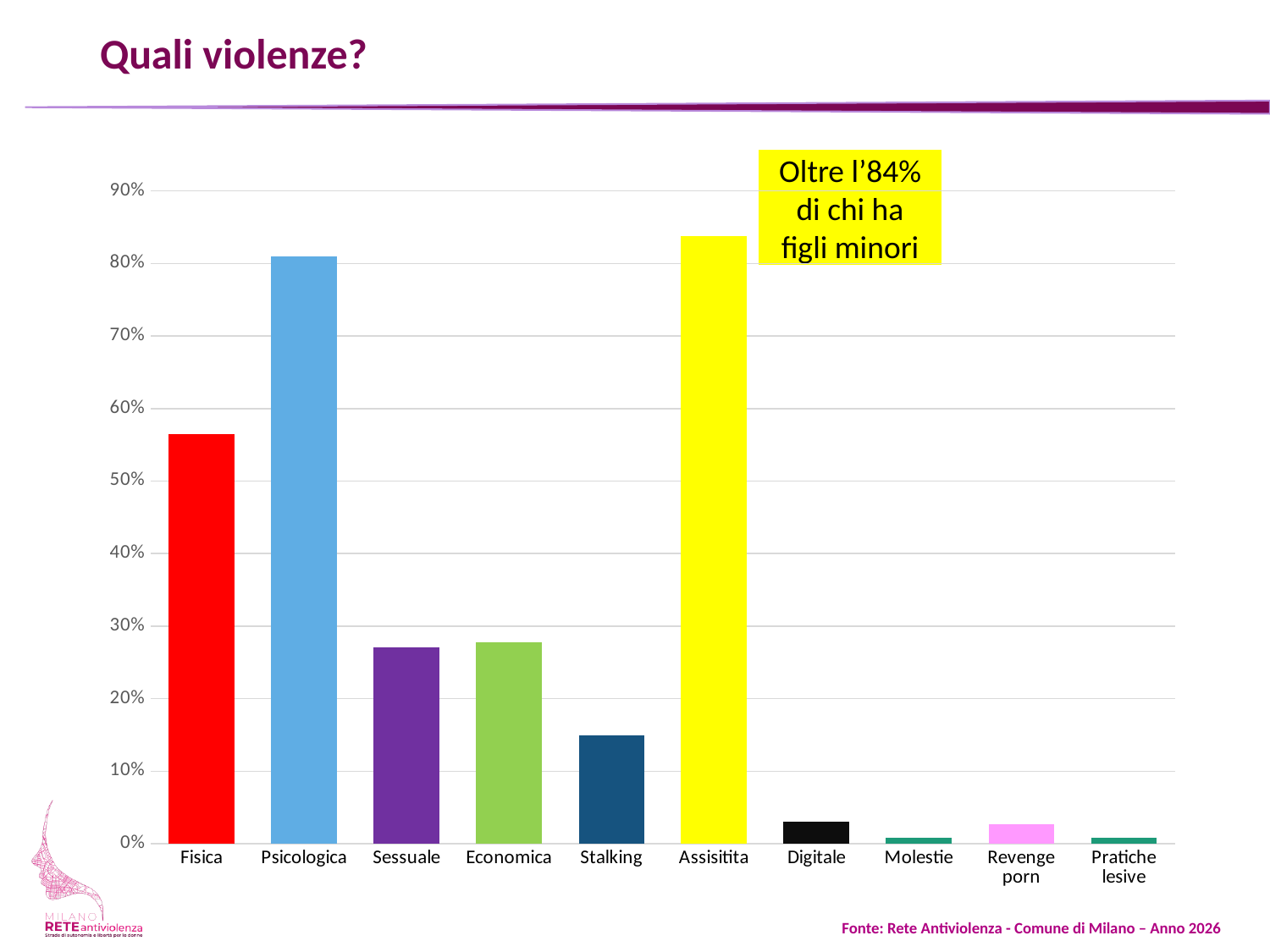
Which is larger, the value for Sessuale or the value for Stalking? Sessuale Which is larger, the value for Fisica or the value for Psicologica? Psicologica Is the value for Fisica greater or less than 50%? greater What kind of chart is shown on the slide? bar chart Is the value for Stalking greater or less than 20%? less Is the value for Digitale greater or less than 10%? less What is the title of the slide containing the chart? Quali violenze? How many categories are shown on the x axis of the chart? 10 What does the yellow annotation box next to the Assistita bar say? Oltre l'84% di chi ha figli minori Which category has the tallest bar in the chart? Assisitita